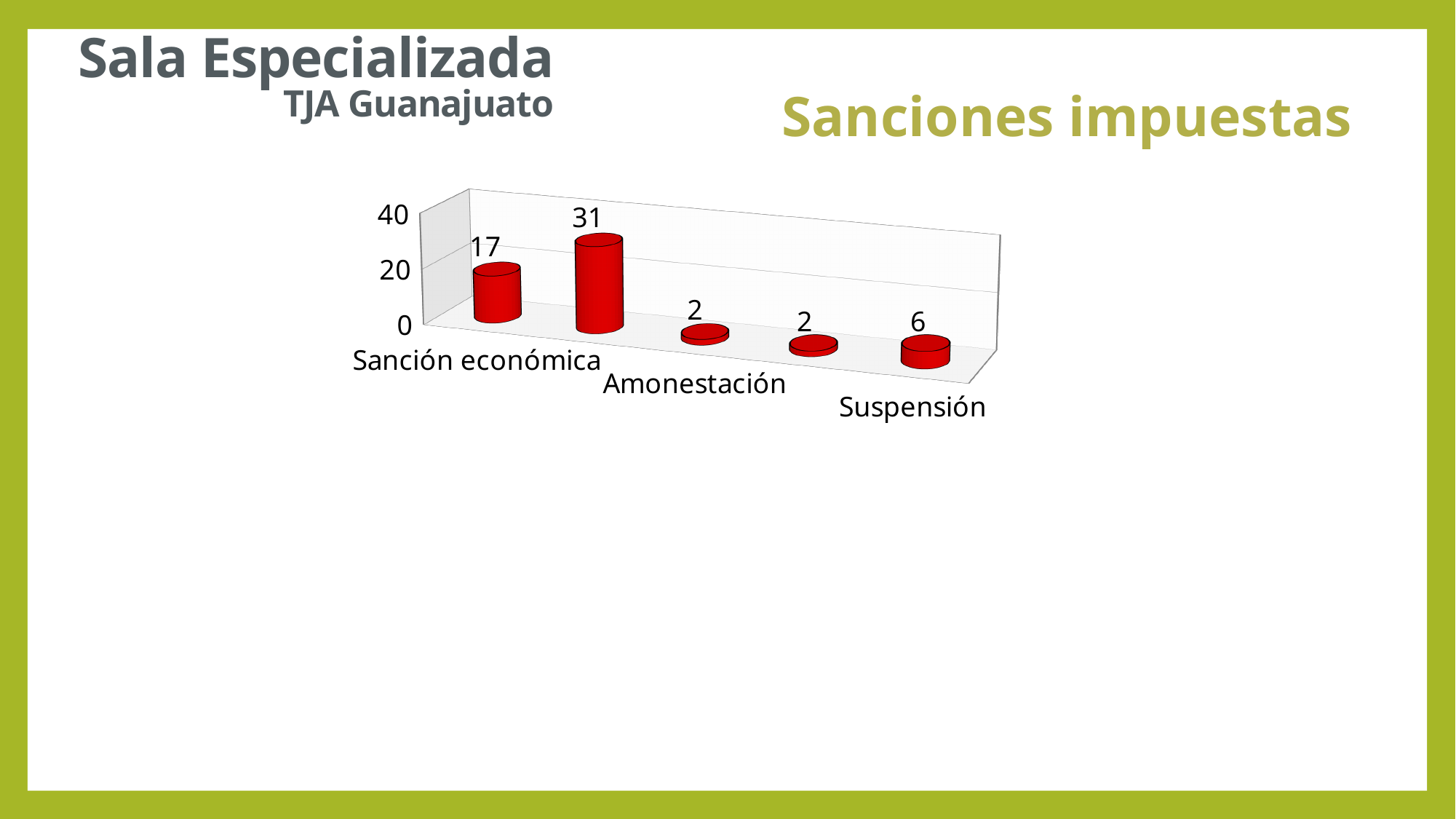
What is the lowest value shown on the chart? 2 What is the value for Suspensión? 6 What is the difference between the values for Sanción económica and Suspensión? 11 Which is larger, the value for Sanción económica or the value for Suspensión? Sanción económica What kind of chart is shown on the slide? bar chart What is the highest value shown on the chart? 31 Is the value for Sanción económica greater or less than 20? less What colour are the bars in the chart? red What is the title of the chart? Sanciones impuestas What is the value for Sanción económica? 17 How many bars are plotted on the chart? 5 What is the value for Amonestación? 2